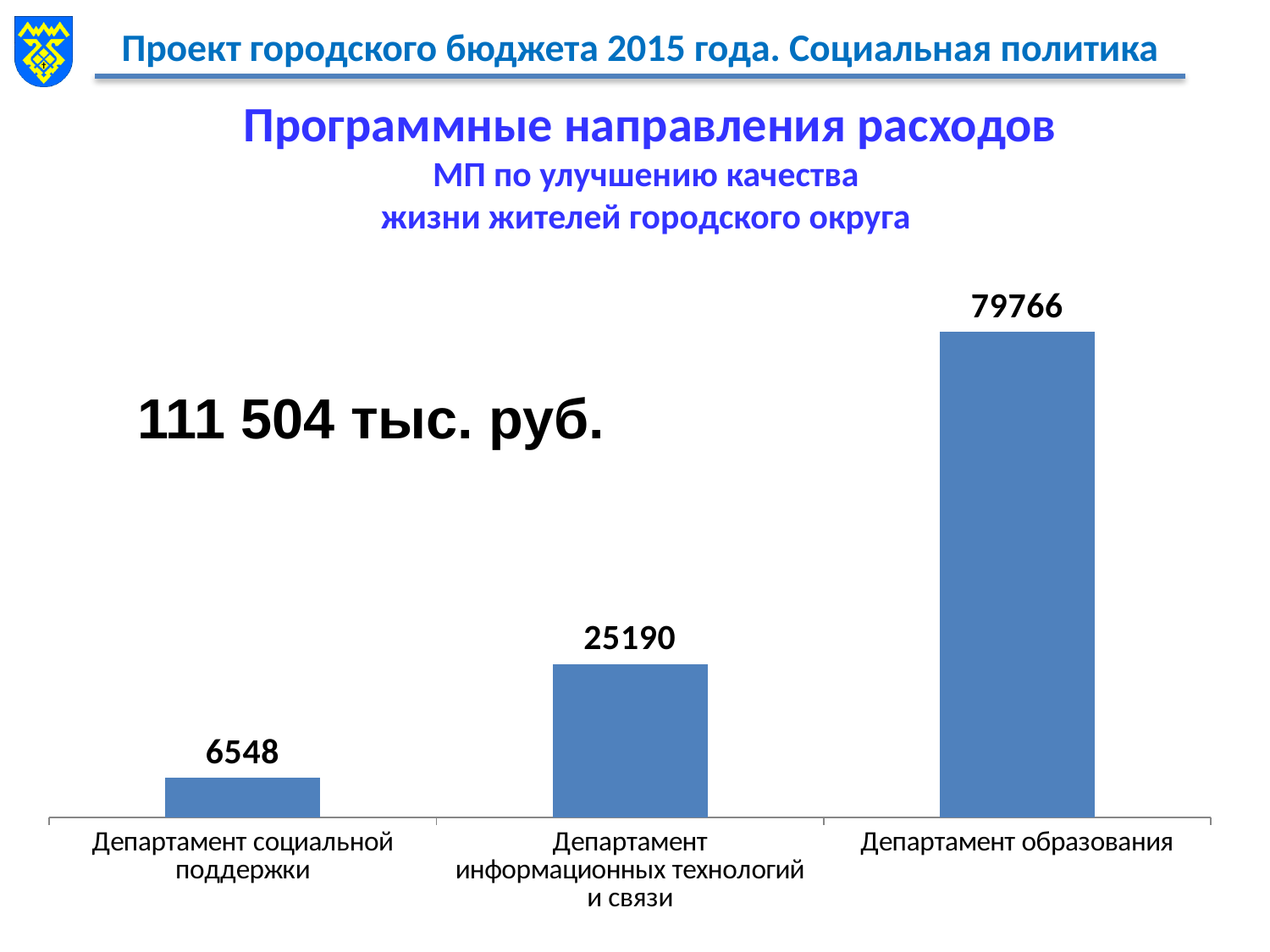
What is the value for Департамент информационных технологий и связи? 25190 Which category has the lowest value? Департамент социальной поддержки What total amount is printed on the slide next to the chart? 111 504 тыс. руб. What is the value for Департамент социальной поддержки? 6548 What is the difference between the values for Департамент образования and Департамент информационных технологий и связи? 54576 What is the difference between the values for Департамент информационных технологий и связи and Департамент социальной поддержки? 18642 Which category has the highest value? Департамент образования How many categories are shown in the chart? 3 What kind of chart is shown on the slide? Bar chart What is the value for Департамент образования? 79766 Which is larger, the value for Департамент социальной поддержки or the value for Департамент информационных технологий и связи? Департамент информационных технологий и связи Do the values rise or fall from left to right along the x axis? Rise